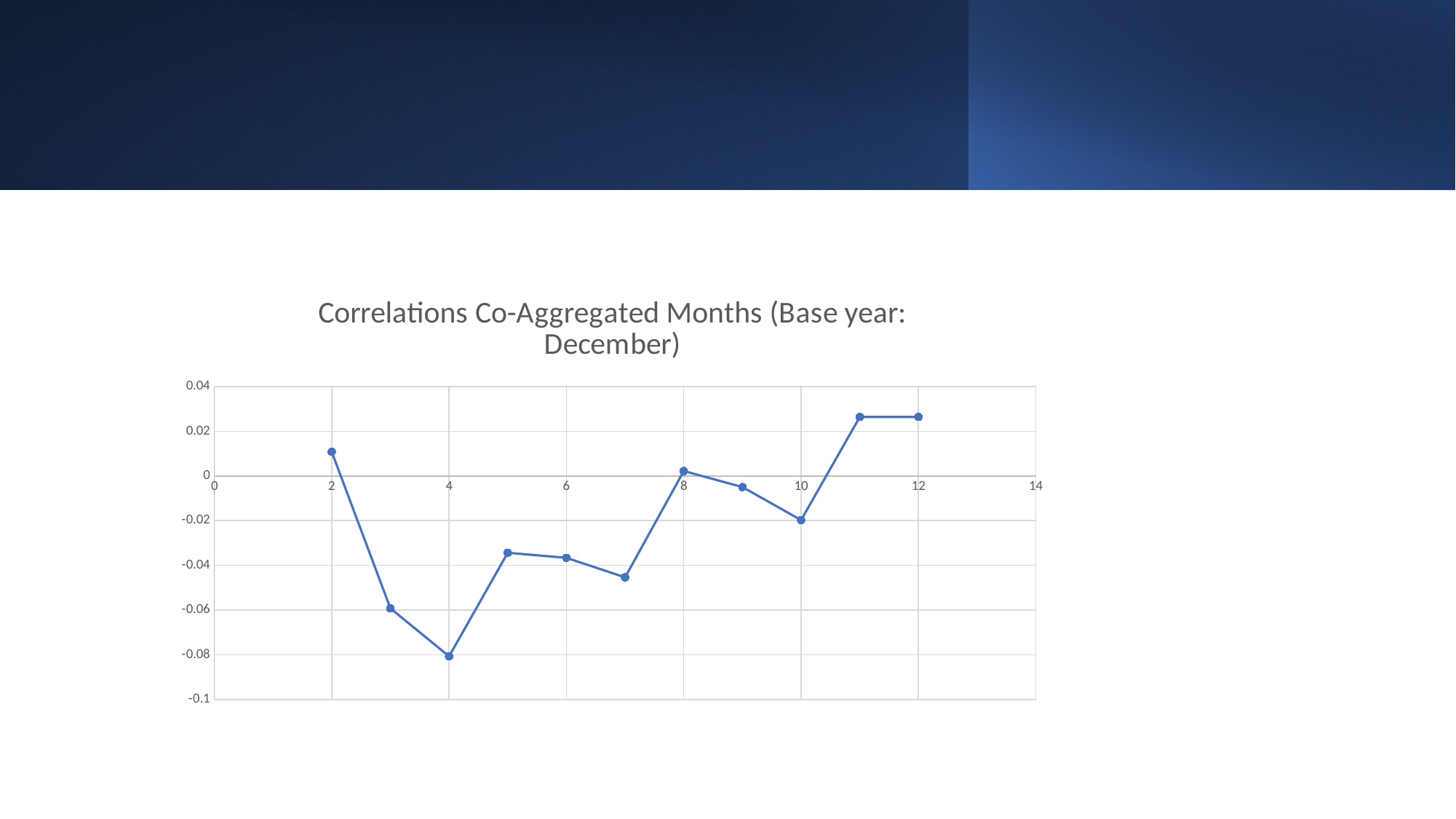
Which has the larger value, x = 2 or x = 3? x = 2 Is the value at x = 7 greater or less than -0.04? less Is the value at x = 11 greater or less than 0.02? greater What is the lowest value shown on the vertical axis? -0.1 At which x value does the line reach its lowest point? 4 Is the value at x = 4 greater or less than -0.06? less Which has the larger value, x = 8 or x = 10? x = 8 What kind of chart is shown on the slide? line chart Do the values rise or fall from x = 2 to x = 4? fall How many data points are plotted on the line? 11 What is the title of the chart? Correlations Co-Aggregated Months (Base year: December)